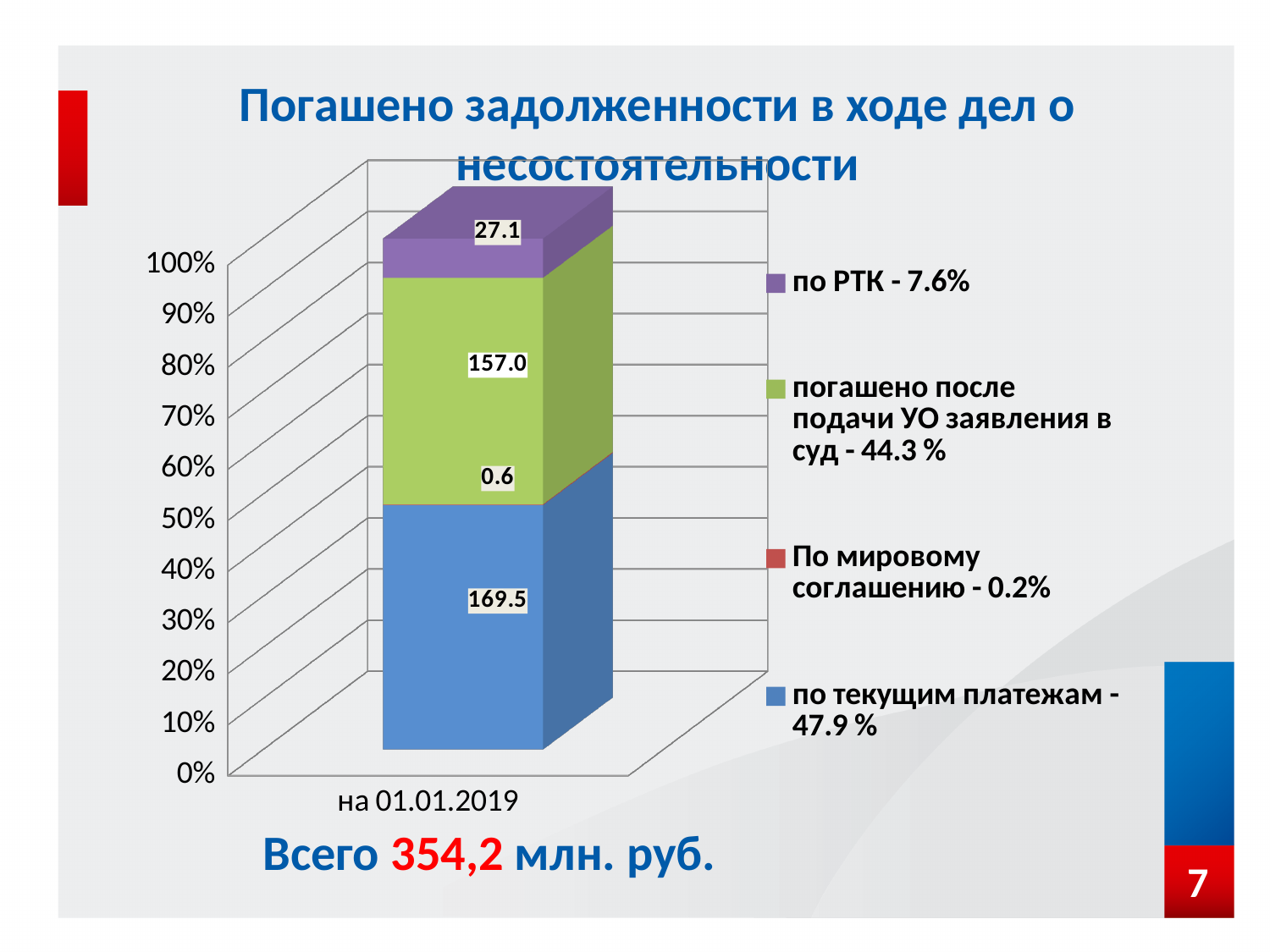
Which series has the smallest value in the stacked bar? По мировому соглашению What is the data label for the series 'по РТК'? 27.1 Which series has the largest value in the stacked bar? по текущим платежам What is the difference between the values for 'по текущим платежам' and 'погашено после подачи УО заявления в суд'? 12.5 What is the category label shown on the x axis? на 01.01.2019 What share of the total does the legend give for 'по РТК'? 7.6% How many series does the legend list? 4 What is the data label for the series 'По мировому соглашению'? 0.6 How many categories are shown on the x axis? 1 What is the data label for the series 'погашено после подачи УО заявления в суд'? 157.0 What is the data label for the series 'по текущим платежам'? 169.5 What type of chart is shown on the slide? bar chart